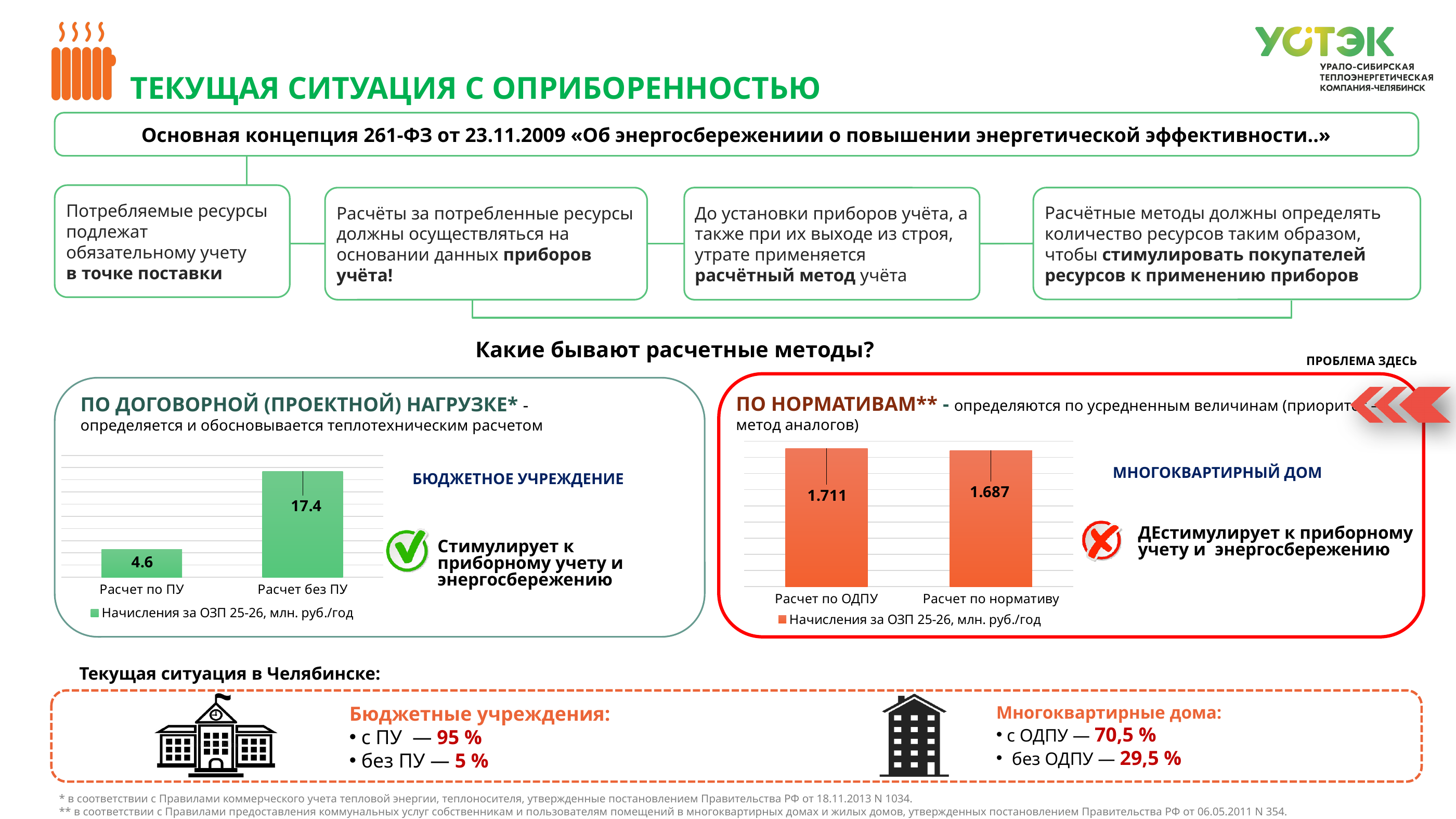
In the left chart (ПО ДОГОВОРНОЙ (ПРОЕКТНОЙ) НАГРУЗКЕ), what is the value for Расчет без ПУ? 17.4 In the left chart (ПО ДОГОВОРНОЙ (ПРОЕКТНОЙ) НАГРУЗКЕ), how many categories are shown? 2 What is the legend entry of the left chart (ПО ДОГОВОРНОЙ (ПРОЕКТНОЙ) НАГРУЗКЕ)? Начисления за ОЗП 25-26, млн. руб./год In the left chart (ПО ДОГОВОРНОЙ (ПРОЕКТНОЙ) НАГРУЗКЕ), what is the difference between Расчет без ПУ and Расчет по ПУ? 12.8 In the right chart (ПО НОРМАТИВАМ), which category has the lowest value? Расчет по нормативу What kind of chart is the right chart (ПО НОРМАТИВАМ)? Bar chart In the left chart (ПО ДОГОВОРНОЙ (ПРОЕКТНОЙ) НАГРУЗКЕ), what is the value for Расчет по ПУ? 4.6 In the right chart (ПО НОРМАТИВАМ), how many series does the legend list? 1 In the right chart (ПО НОРМАТИВАМ), what is the value for Расчет по ОДПУ? 1.711 In the left chart (ПО ДОГОВОРНОЙ (ПРОЕКТНОЙ) НАГРУЗКЕ), which category has the highest value? Расчет без ПУ In the right chart (ПО НОРМАТИВАМ), what is the difference between Расчет по ОДПУ and Расчет по нормативу? 0.024 In the right chart (ПО НОРМАТИВАМ), what is the value for Расчет по нормативу? 1.687